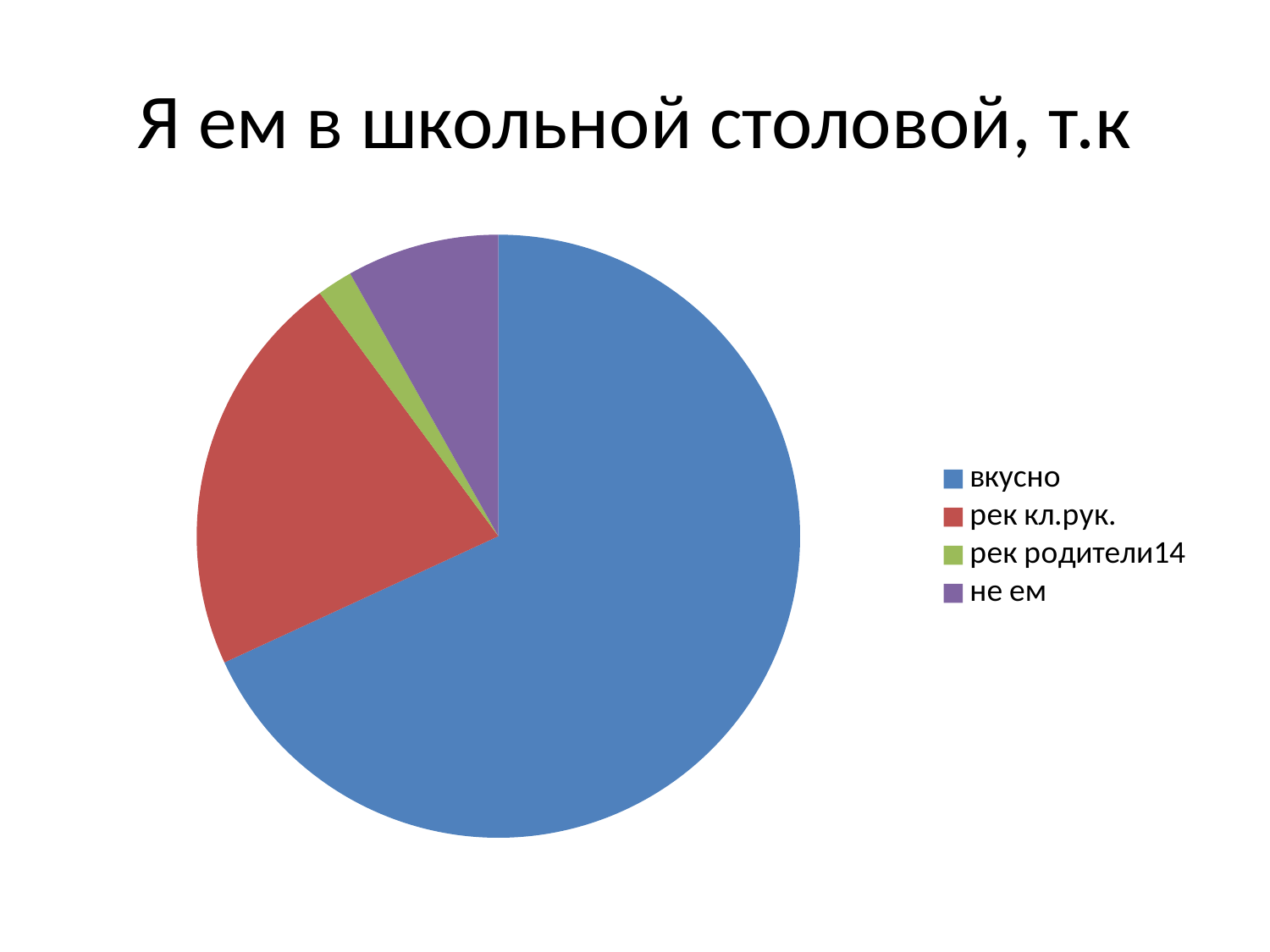
Which slice is larger, вкусно or рек кл.рук.? вкусно Which category has the largest slice of the pie chart? вкусно Which category has the smallest slice of the pie chart? рек родители14 Which slice is larger, не ем or рек родители14? не ем What is the title of the slide with the pie chart? Я ем в школьной столовой, т.к Which slice is larger, рек кл.рук. or не ем? рек кл.рук. What colour is the slice for не ем in the pie chart? purple How many entries does the legend of the pie chart list? 4 What kind of chart is shown on the slide? pie chart How many slices does the pie chart have? 4